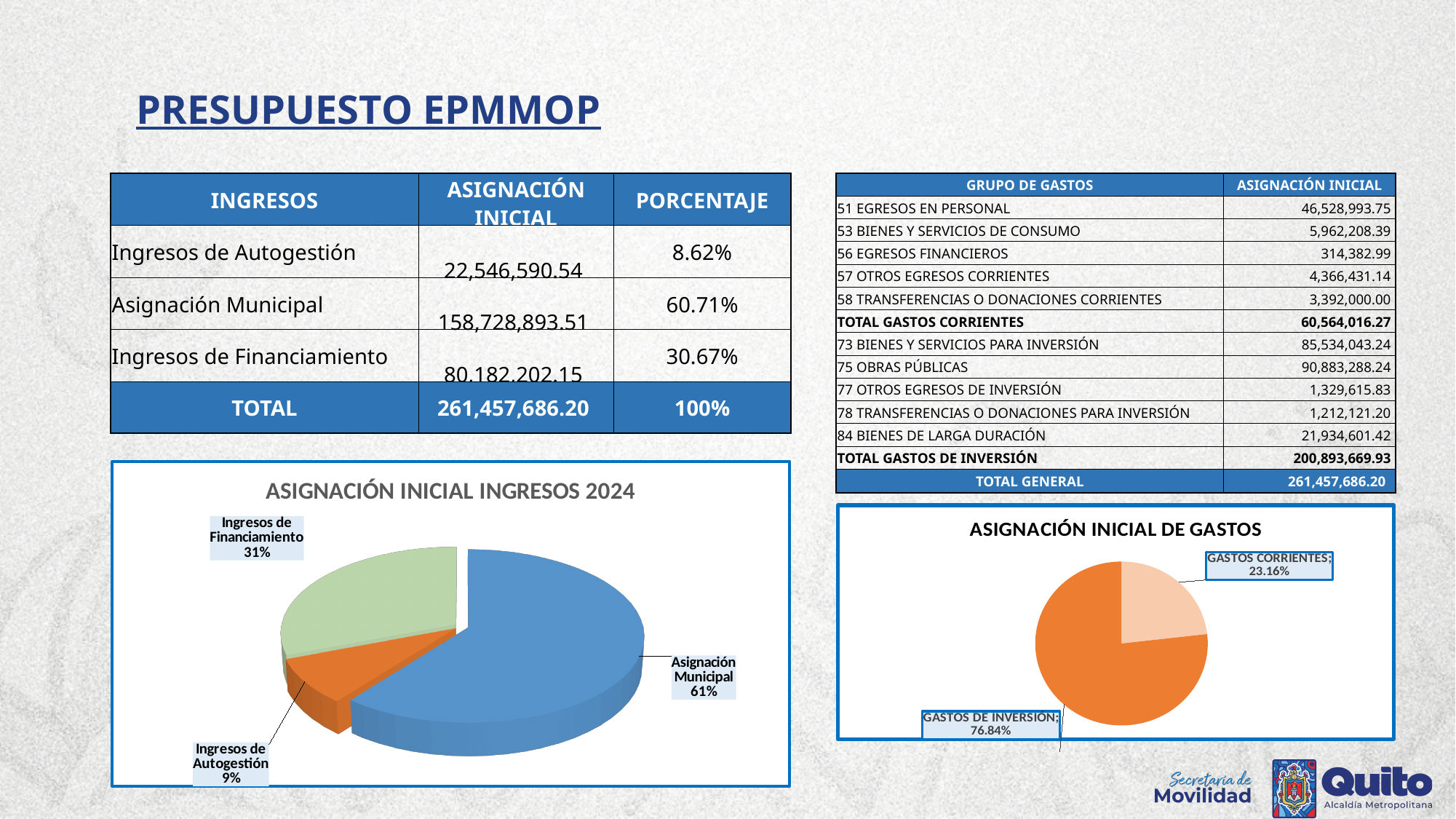
In the chart titled 'ASIGNACIÓN INICIAL INGRESOS 2024', which category has the smallest slice? Ingresos de Autogestión What kind of chart is 'ASIGNACIÓN INICIAL INGRESOS 2024'? Pie chart In the chart titled 'ASIGNACIÓN INICIAL DE GASTOS', what is the difference in percentage points between Gastos de Inversión and Gastos Corrientes? 53.68 In the chart titled 'ASIGNACIÓN INICIAL DE GASTOS', what colour is the Gastos de Inversión slice? Orange In the chart titled 'ASIGNACIÓN INICIAL DE GASTOS', what share does Gastos Corrientes have? 23.16% In the chart titled 'ASIGNACIÓN INICIAL INGRESOS 2024', how many slices does the pie have? 3 In the chart titled 'ASIGNACIÓN INICIAL INGRESOS 2024', what share does Ingresos de Autogestión have? 9% In the chart titled 'ASIGNACIÓN INICIAL DE GASTOS', which category is larger, Gastos Corrientes or Gastos de Inversión? Gastos de Inversión In the chart titled 'ASIGNACIÓN INICIAL INGRESOS 2024', what share does Asignación Municipal have? 61% In the chart titled 'ASIGNACIÓN INICIAL INGRESOS 2024', which category has the largest slice? Asignación Municipal